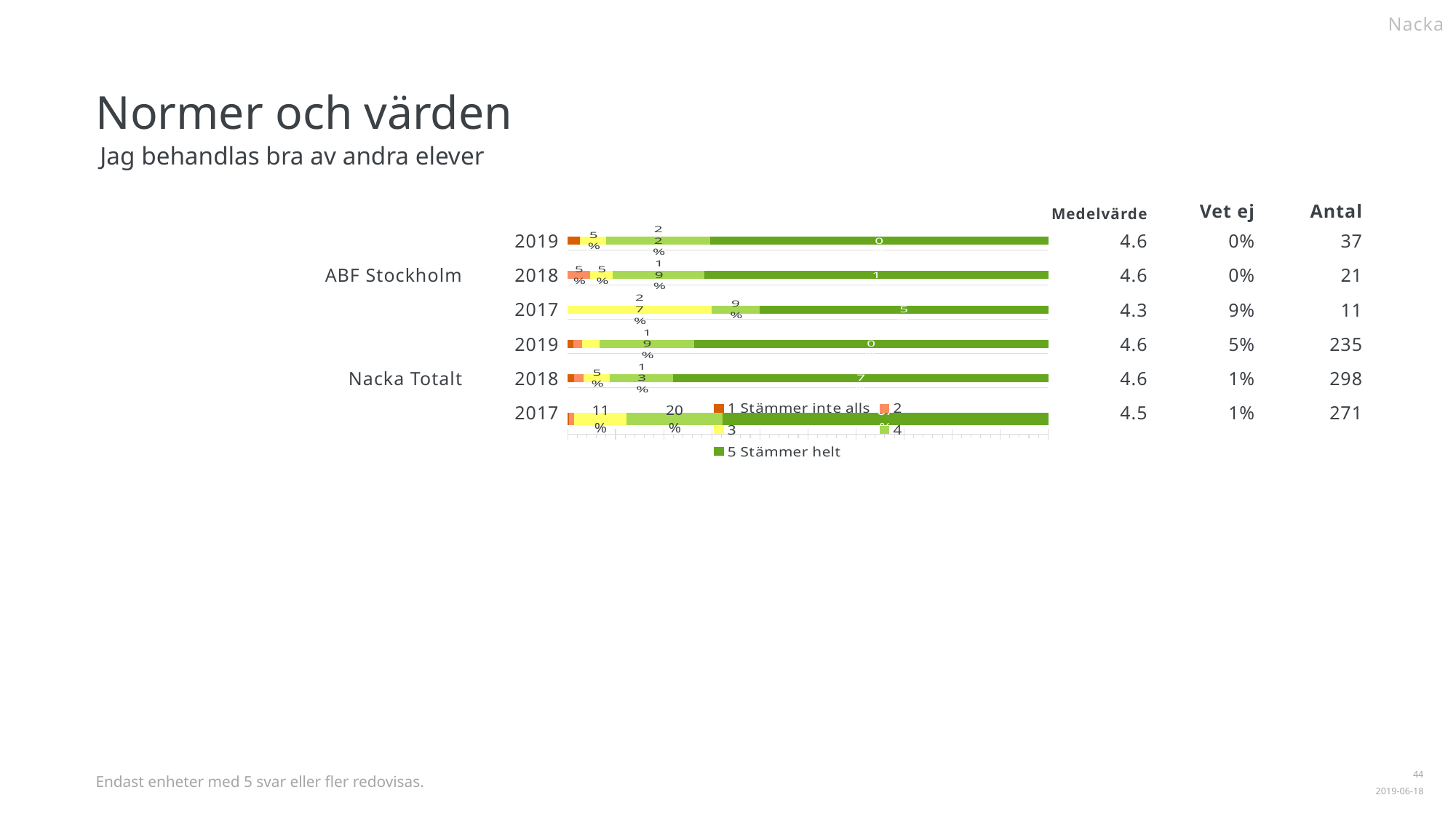
Which row has the lowest Medelvärde? ABF Stockholm 2017 What kind of chart is shown on the slide? bar chart What is the last entry in the chart legend? 5 Stämmer helt How many bars are plotted in the chart? 6 In the Nacka Totalt 2017 bar, which segment is larger: series 3 or 5 Stämmer helt? 5 Stämmer helt What is the Medelvärde shown for ABF Stockholm 2017? 4.3 Which row has the highest Antal? Nacka Totalt 2018 How many series does the chart legend list? 5 In the Nacka Totalt 2017 bar, what is the value for series 4? 20% What is the first entry in the chart legend? 1 Stämmer inte alls Which bar has the largest segment for series 3 (yellow)? ABF Stockholm 2017 In the Nacka Totalt 2017 bar, what is the value for series 3? 11%